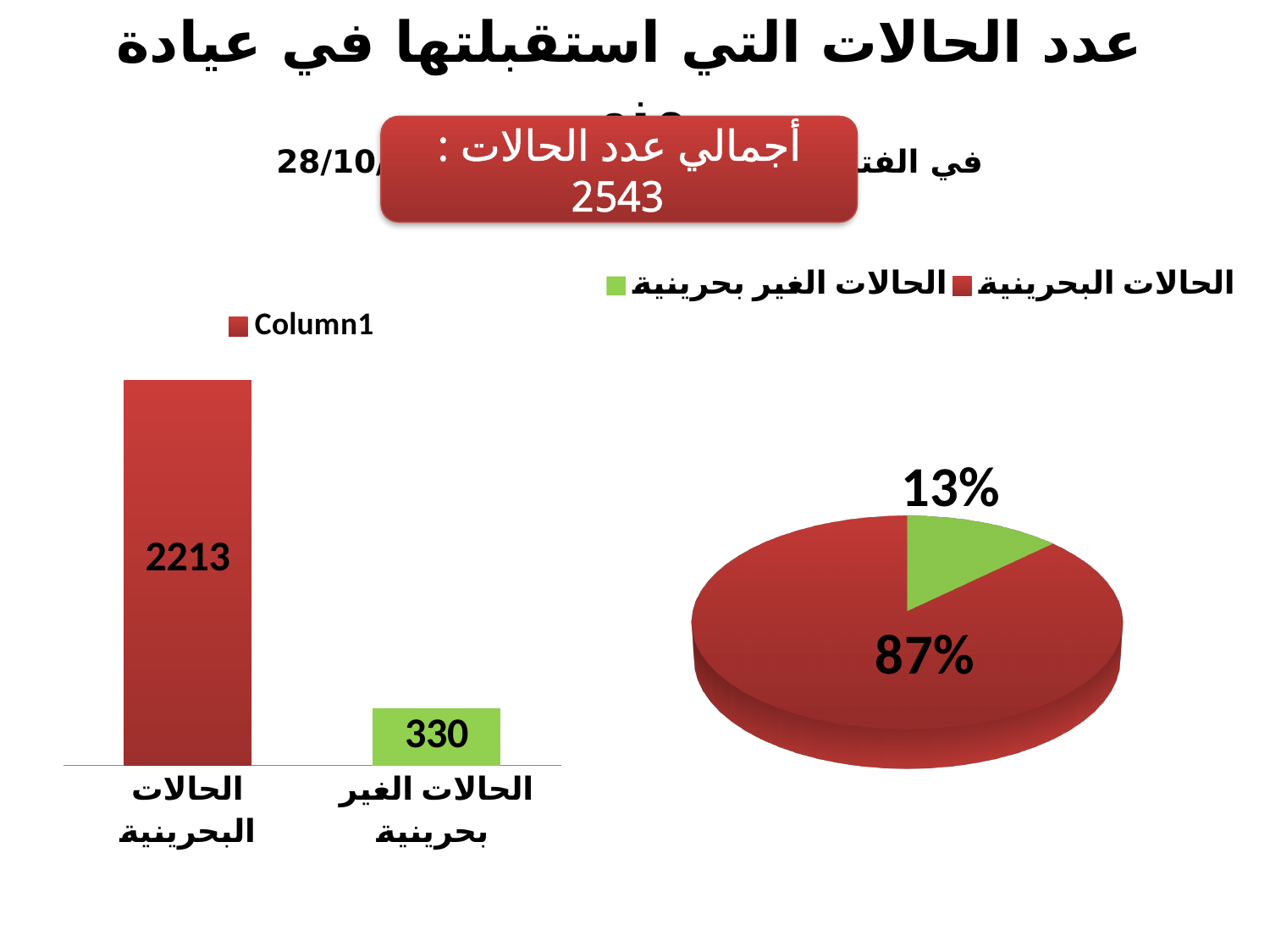
What kind of chart is the chart on the right of the slide? Pie chart What is the legend entry shown above the bar chart on the left? Column1 In the bar chart on the left, which category has the lowest value? الحالات الغير بحرينية What kind of chart is the chart on the left of the slide? Bar chart In the bar chart on the left, what is the value for الحالات الغير بحرينية? 330 In the bar chart on the left, which category has the highest value? الحالات البحرينية In the bar chart on the left, which is larger: الحالات البحرينية or الحالات الغير بحرينية? الحالات البحرينية In the bar chart on the left, what is the difference between the values for الحالات البحرينية and الحالات الغير بحرينية? 1883 In the pie chart on the right, what share does الحالات البحرينية have? 87% How many categories does the bar chart on the left show? 2 In the pie chart on the right, what share does الحالات الغير بحرينية have? 13% In the bar chart on the left, what is the value for الحالات البحرينية? 2213